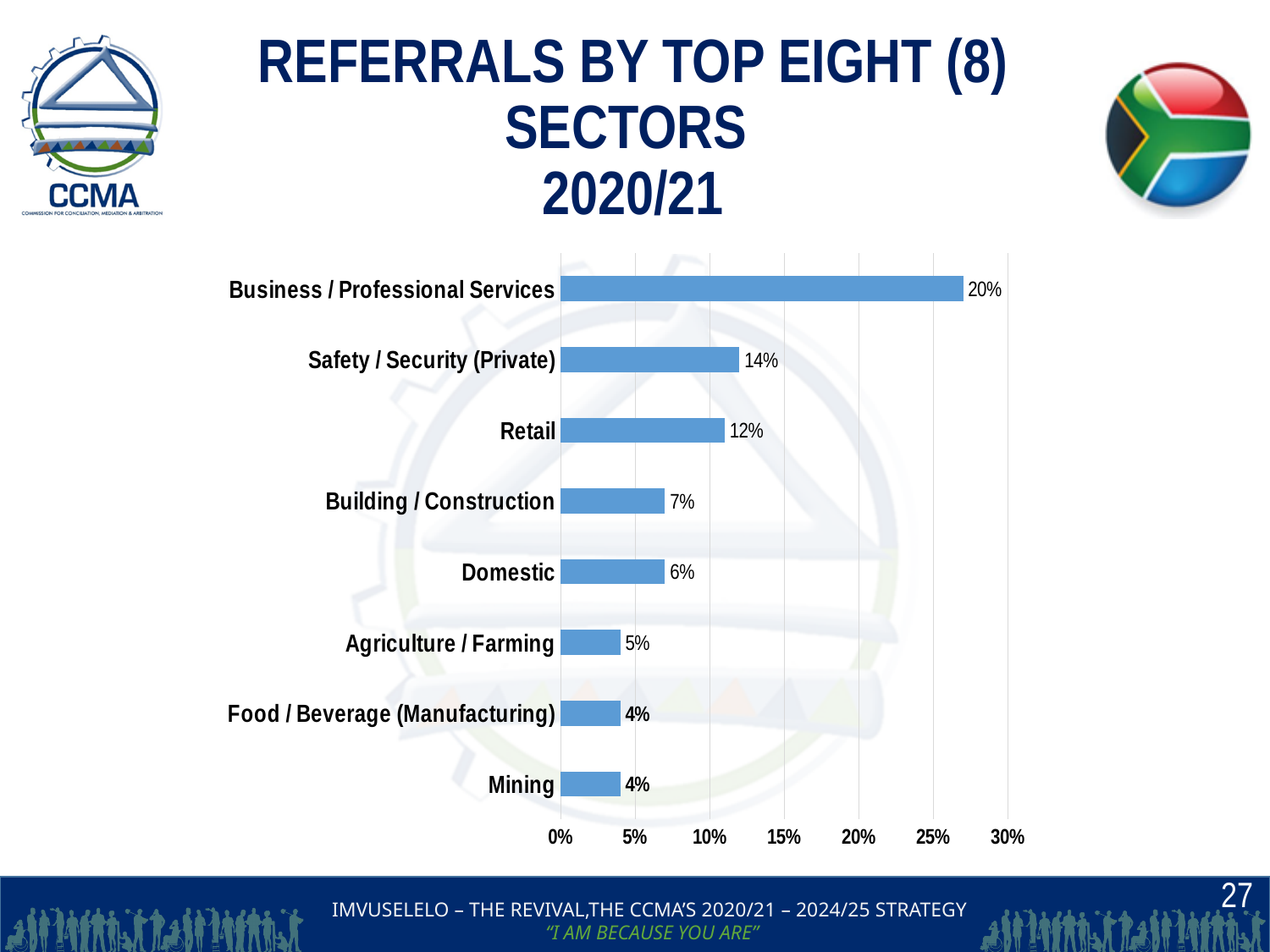
How many sectors are shown in the chart? 8 What is the value for Retail? 12% What is the value for Safety / Security (Private)? 14% Which is larger, the value for Retail or the value for Domestic? Retail What is the value for Domestic? 6% What is the value for Business / Professional Services? 20% What is the difference between the values for Retail and Building / Construction? 5% Which sector has the highest share of referrals? Business / Professional Services Is the value for Safety / Security (Private) greater or less than 10%? greater What kind of chart is shown on the slide? Bar chart What is the title of the chart? REFERRALS BY TOP EIGHT (8) SECTORS 2020/21 What is the difference between the values for Business / Professional Services and Safety / Security (Private)? 6%